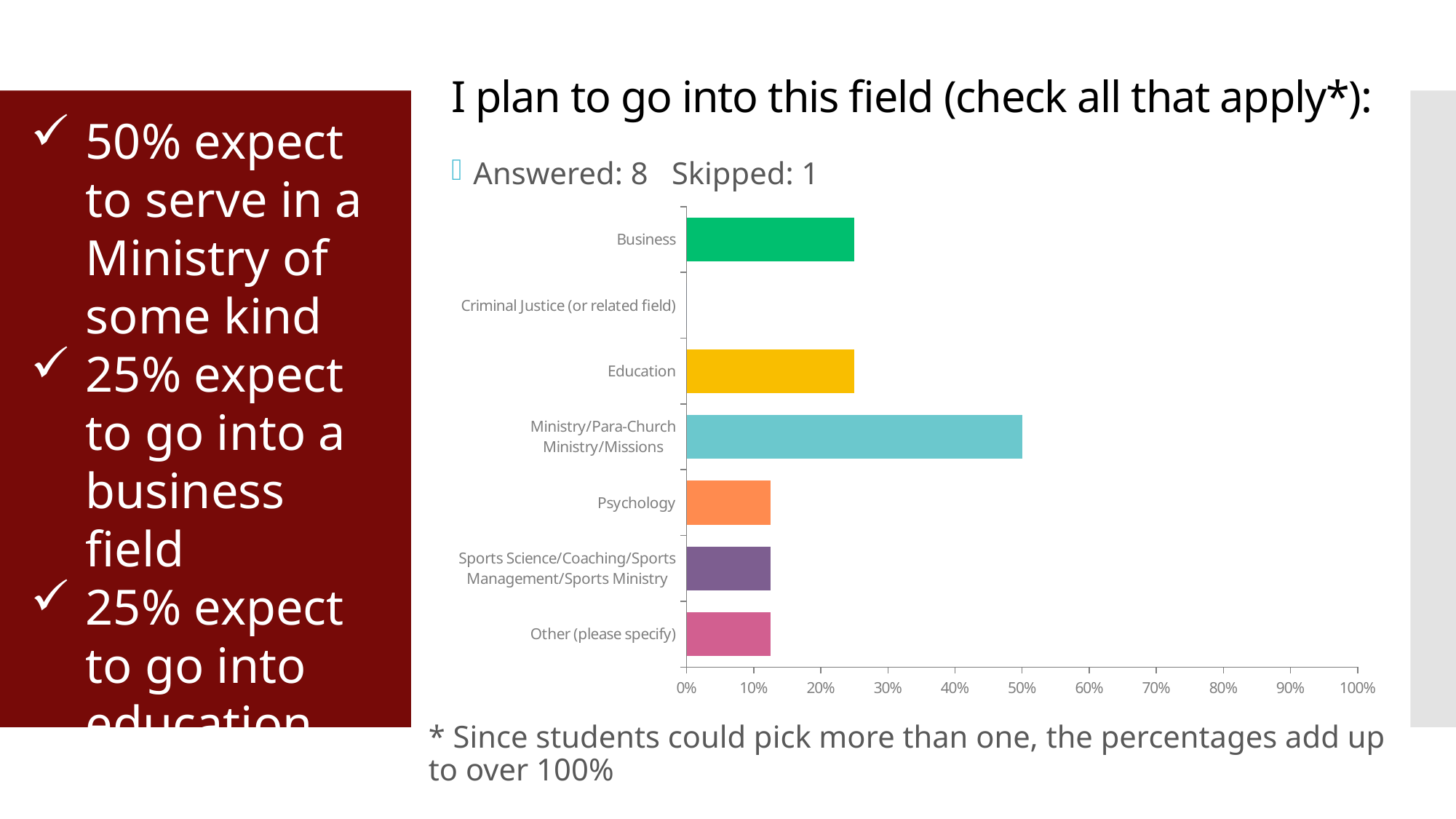
Is the value for Education greater or less than 30%? less What percentage of respondents plan to go into Ministry/Para-Church Ministry/Missions? 50% Which field has the lowest percentage on the chart? Criminal Justice (or related field) Which is larger, the value for Ministry/Para-Church Ministry/Missions or the value for Business? Ministry/Para-Church Ministry/Missions What kind of chart is shown on the slide? bar chart How many categories (fields) are listed on the chart? 7 Is the value for Psychology greater or less than 20%? less Which field has the highest percentage on the chart? Ministry/Para-Church Ministry/Missions Which is larger, the value for Business or the value for Psychology? Business What is the title of the chart? I plan to go into this field (check all that apply*): What percentage of respondents plan to go into Criminal Justice (or related field)? 0% Is the value for Business greater or less than 20%? greater